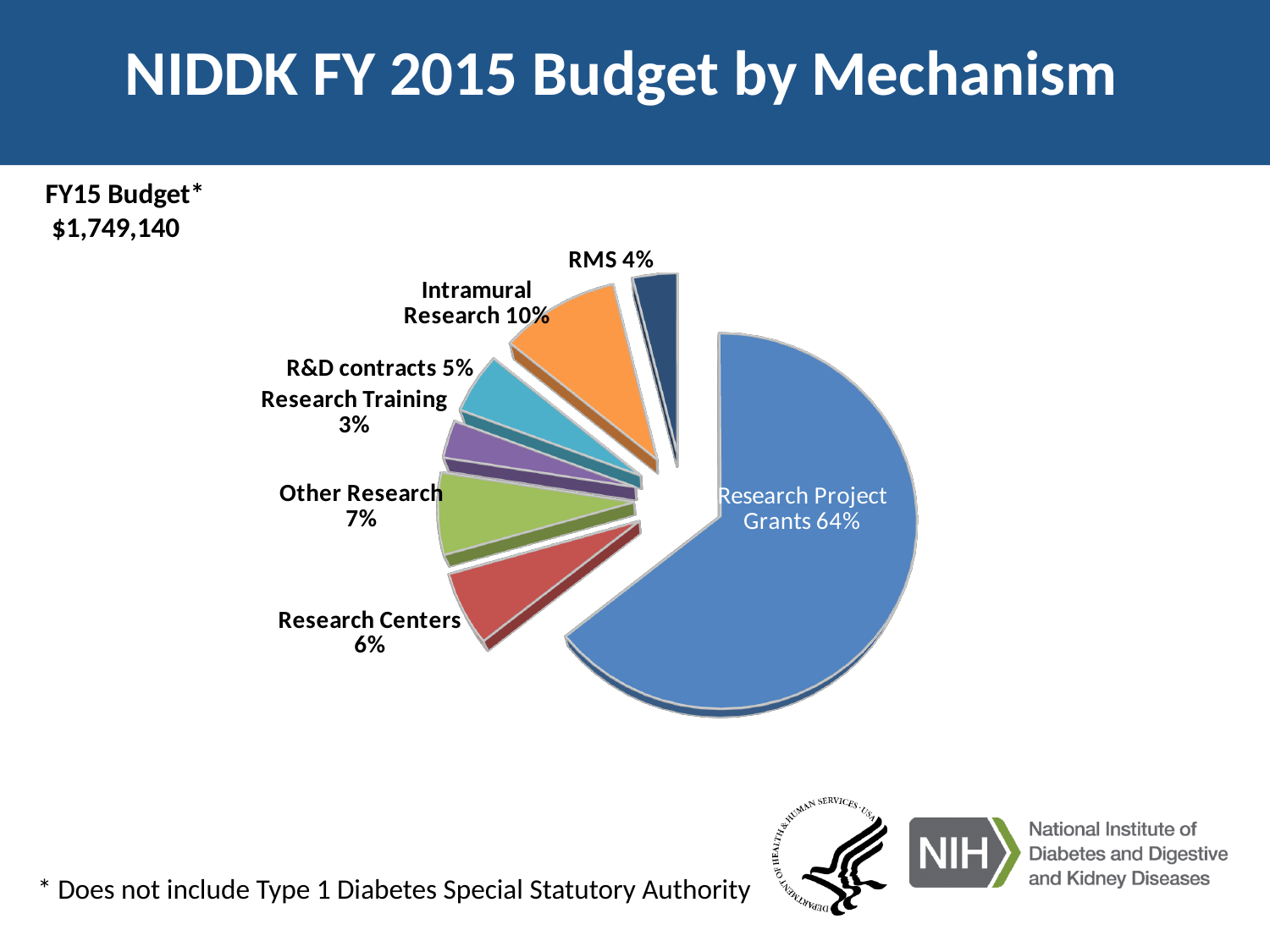
What percentage does RMS account for? 4% How many percentage points larger is the Intramural Research share than the R&D contracts share? 5 How many slices does the pie chart have? 7 Which mechanism receives the largest share of the budget? Research Project Grants What share of the budget is for Research Centers? 6% What type of chart is shown on the slide? Pie chart What is the total FY15 budget shown on the slide? $1,749,140 What percentage of the budget is allocated to Intramural Research? 10% What share of the FY 2015 budget goes to Research Project Grants? 64% What is the title of the slide? NIDDK FY 2015 Budget by Mechanism Which mechanism receives the smallest share of the budget? Research Training Which is larger, the share for Other Research or the share for Research Centers? Other Research